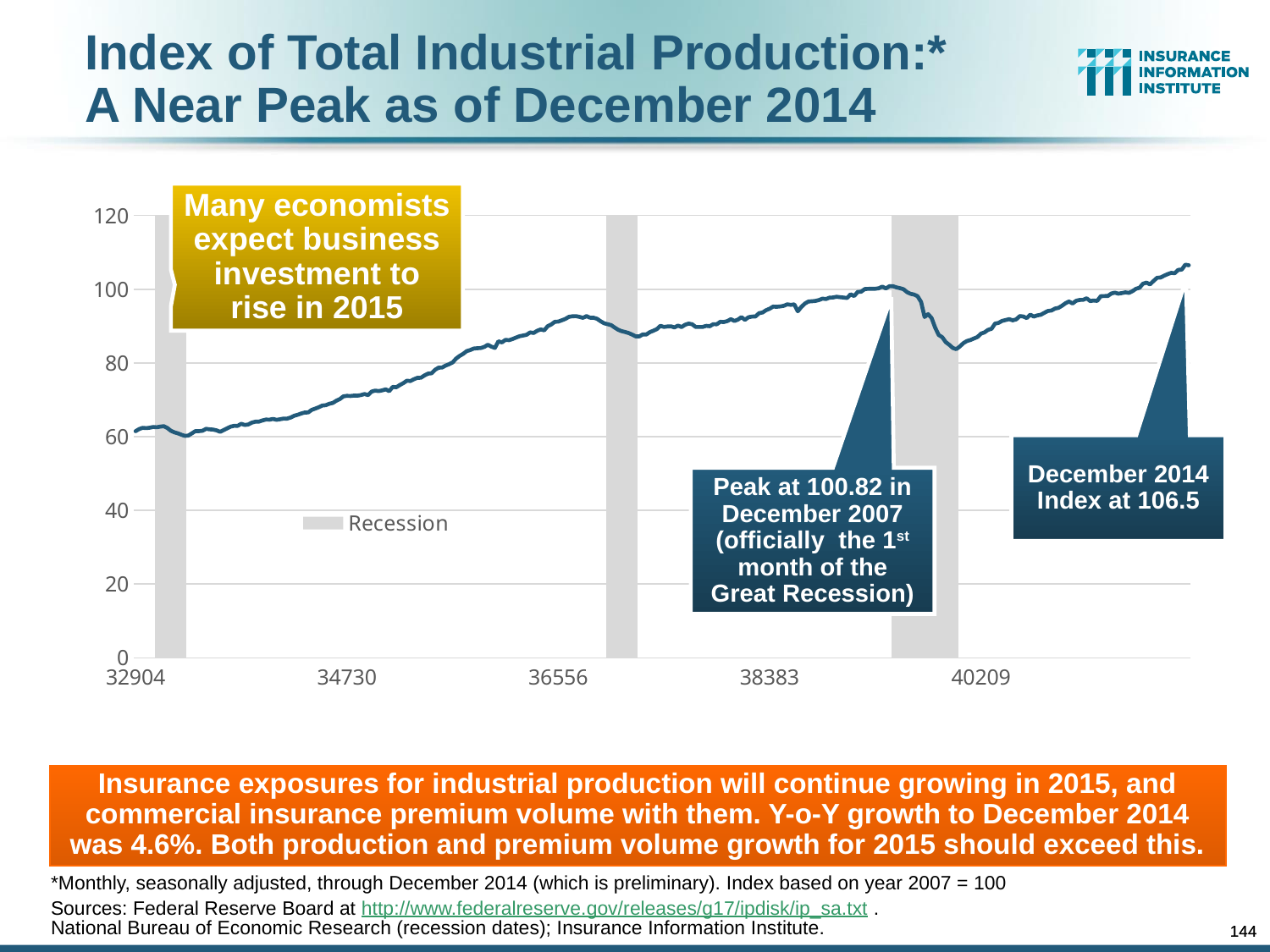
What was the value of the Index of Total Industrial Production at its December 2007 peak? 100.82 By how much does the December 2014 index value exceed the December 2007 peak value? 5.68 What was the Index of Total Industrial Production in December 2014? 106.5 Which is larger: the index value in December 2014 or the peak value in December 2007? December 2014 Is the index value at the start of the chart (x-axis label 32904) greater or less than 80? less Is the index value at the x-axis label 36556 greater or less than 80? greater At which labelled point does the index reach its highest value on the chart? December 2014 Is the index value at the x-axis label 40209 greater or less than 100? less How many grey recession bands are shaded on the chart? 3 What does the grey shading in the chart represent, according to the legend? Recession What kind of chart is shown on the slide? line chart Does the index generally rise or fall from the left of the chart to the right? rise